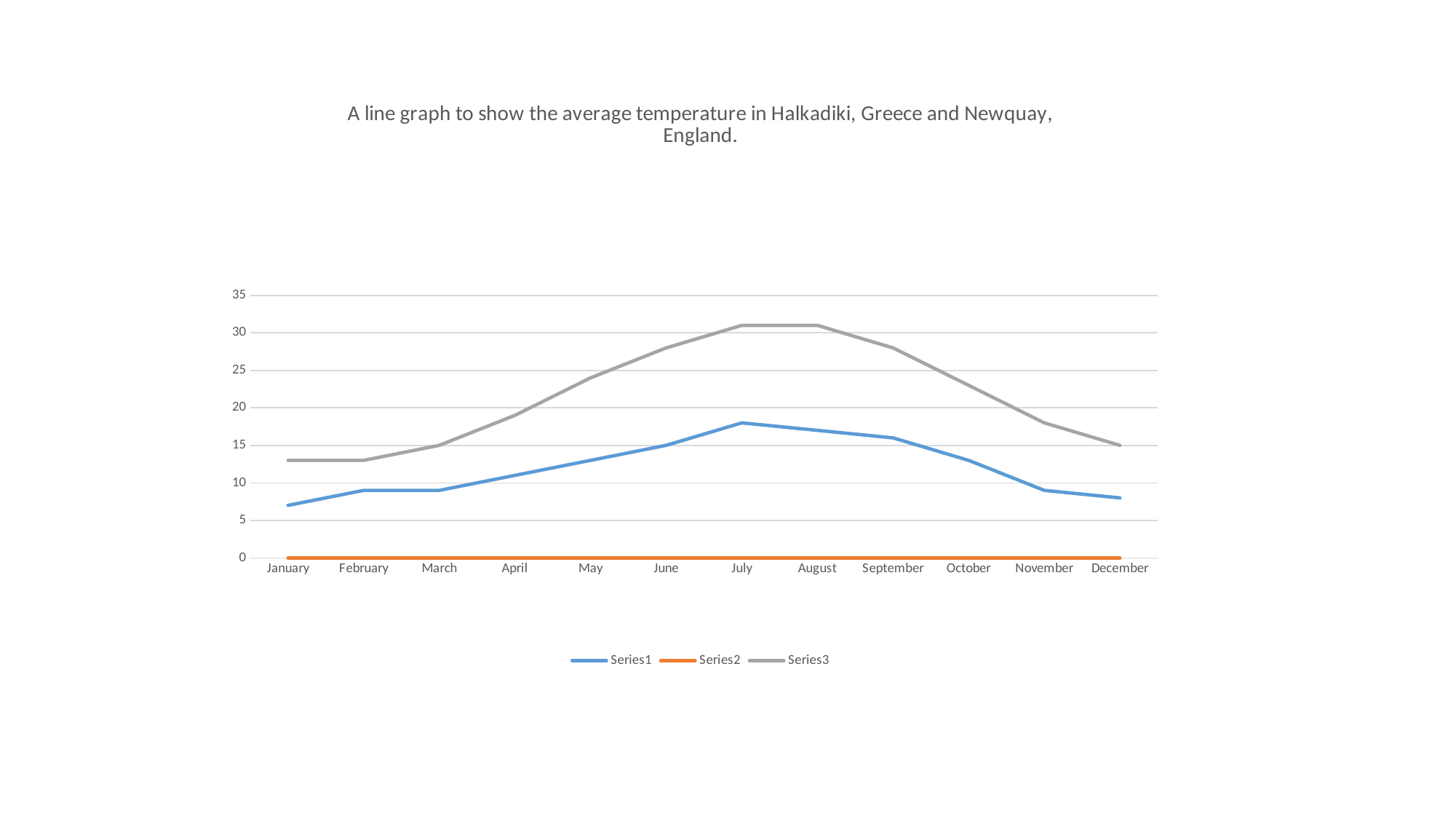
What is the value of Series2 in July? 0 Does Series3 rise or fall from August to December? fall Is the value for Series1 in July greater or less than 20? less Is the value for Series3 in July greater or less than 30? greater What is the value of Series1 in June? 15 What kind of chart is shown on the slide? line chart What is the title of the chart? A line graph to show the average temperature in Halkadiki, Greece and Newquay, England. Which is larger in July, Series1 or Series3? Series3 In which month does Series1 reach its highest value? July How many series does the legend list? 3 How many months are shown along the x axis? 12 What is the value of Series3 in March? 15